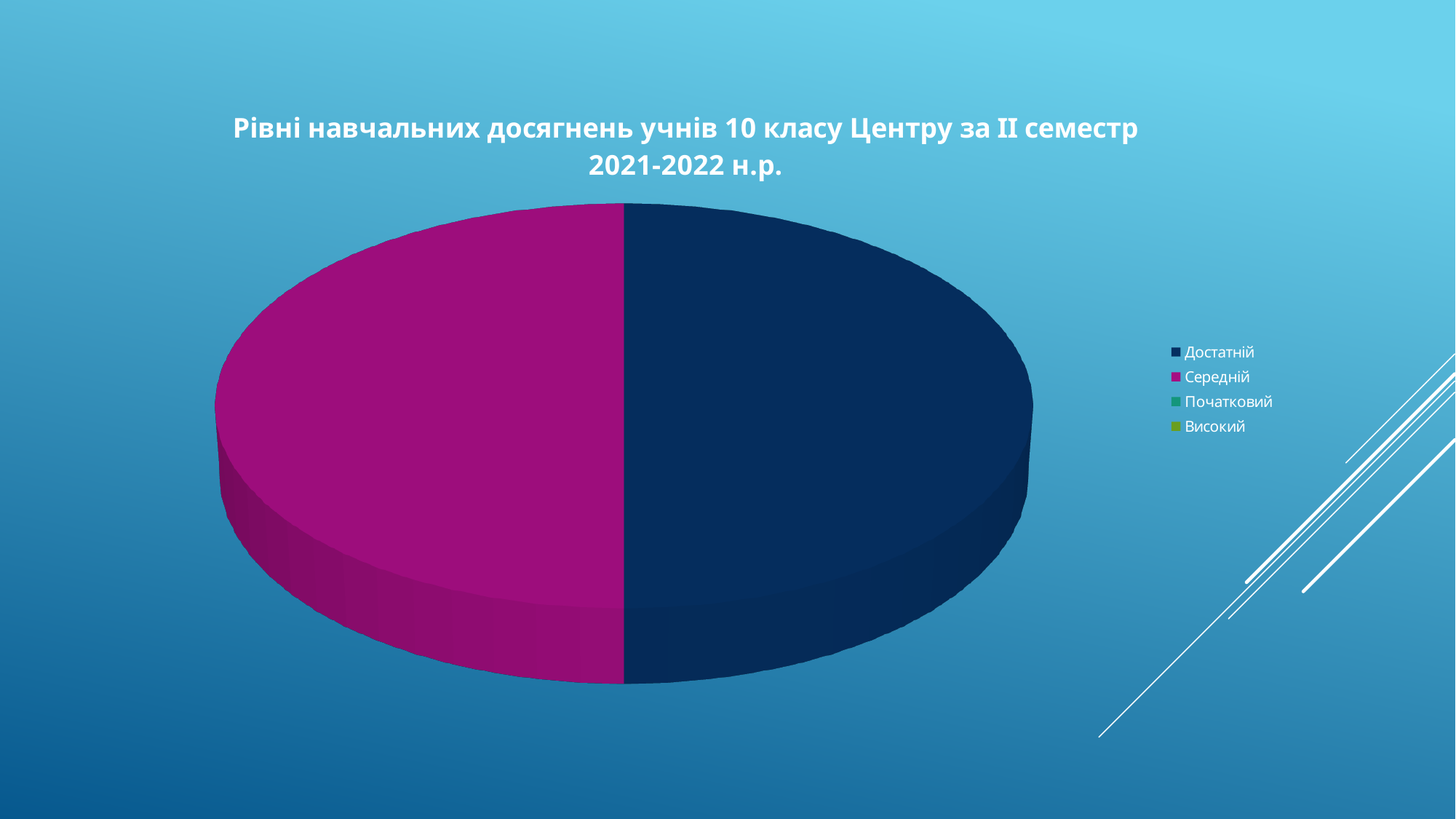
Which category does the magenta slice of the pie chart represent? Середній What is the title of the pie chart? Рівні навчальних досягнень учнів 10 класу Центру за ІІ семестр 2021-2022 н.р. Which legend category is shown in dark blue in the pie chart? Достатній How many entries does the legend of the pie chart list? 4 Which two legend categories have no visible slice in the pie chart? Початковий and Високий What kind of chart is shown on the slide? pie chart Which academic year and semester does the pie chart cover, according to its title? ІІ семестр 2021-2022 н.р. How many slices are visible in the pie chart? 2